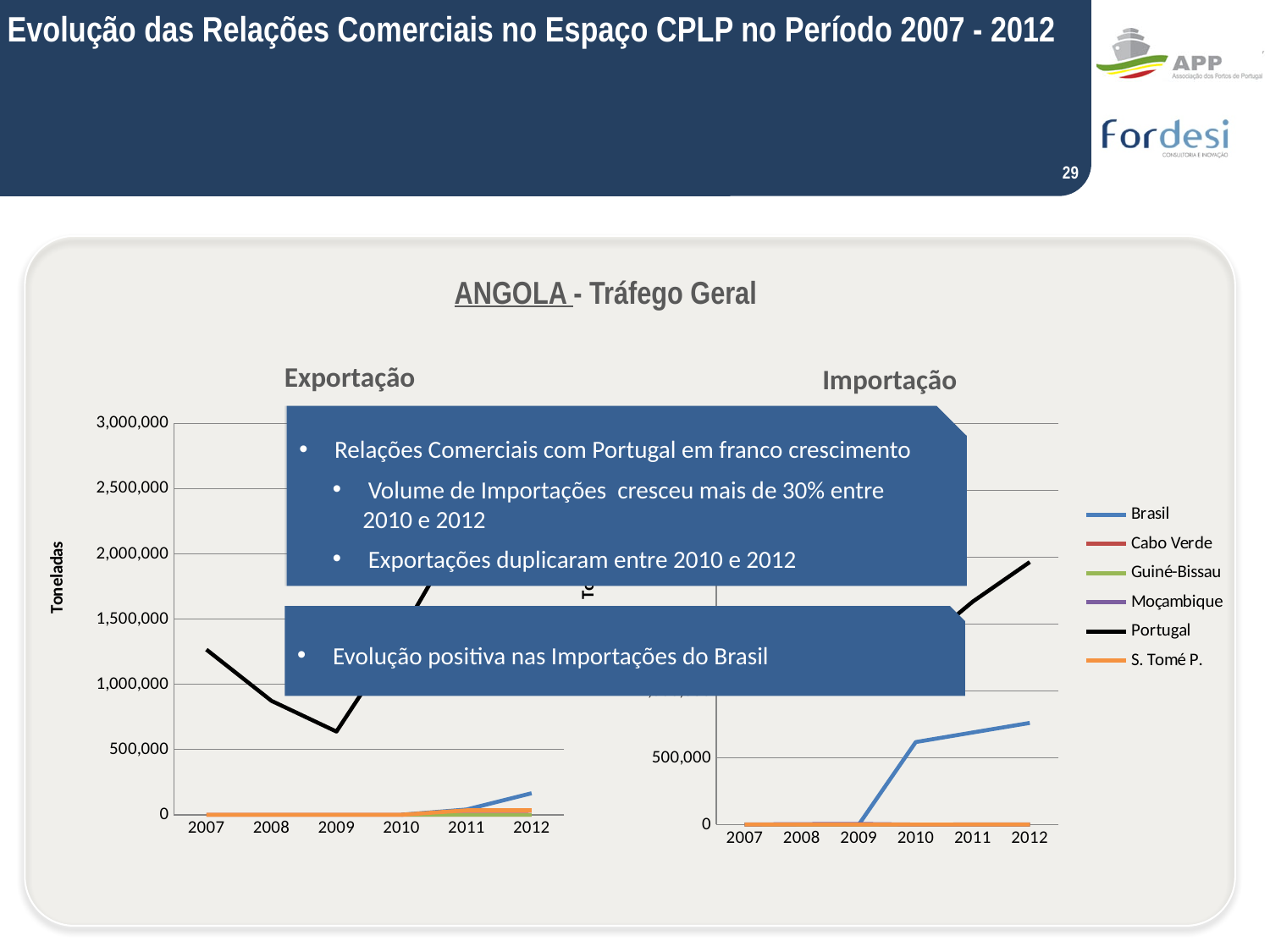
What colour is the Portugal line in the legend? black In the Importação chart, does the Brasil line rise or fall from 2009 to 2012? rise In the Exportação chart, is the value for Portugal in 2009 greater or less than 1,000,000? less In the Importação chart, which series is larger in 2012: Portugal or Brasil? Portugal How many series does the legend list? 6 In the Importação chart, is the value for Brasil in 2012 greater or less than 500,000? greater In the Exportação chart, is the value for Portugal in 2007 greater or less than 1,000,000? greater In the Exportação chart, which year has the lowest value for Portugal? 2009 What type of chart is used for the Exportação chart? line chart How many years are shown on the x axis of the Importação chart? 6 In the Exportação chart, which is larger for Portugal: 2007 or 2009? 2007